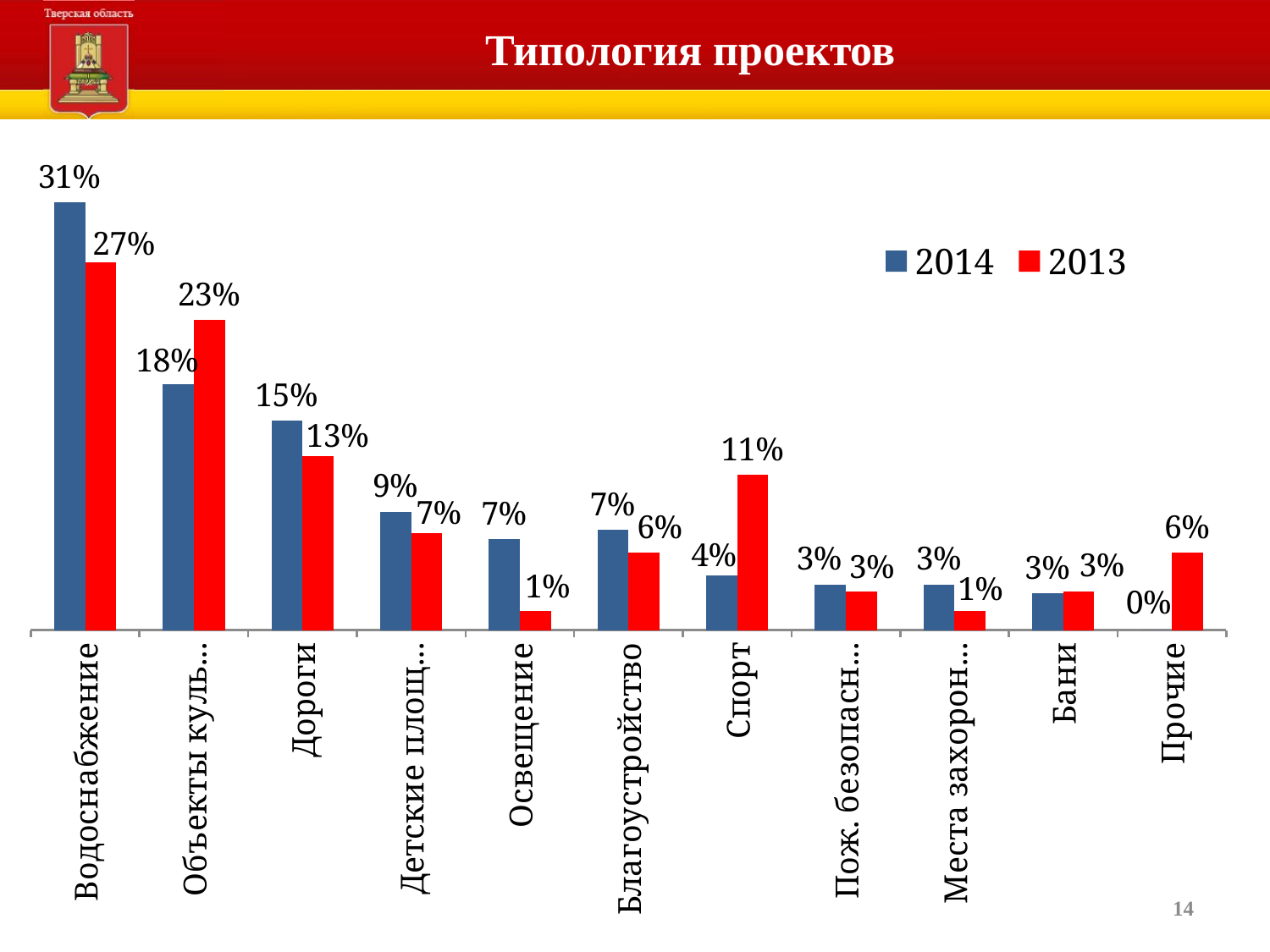
What is the difference between the 2014 and 2013 values for Дороги? 2% What kind of chart is shown on the slide? Bar chart Which is larger for Спорт: the 2014 value or the 2013 value? 2013 What is the title of the slide? Типология проектов Which category has the lowest 2014 value? Прочие What is the 2013 value for Освещение? 1% How many categories are shown on the x axis? 11 What is the 2013 value for Спорт? 11% What is the 2014 value for Водоснабжение? 31% Which category has the highest 2014 value? Водоснабжение What is the 2014 value for Прочие? 0% How many series does the legend list? 2